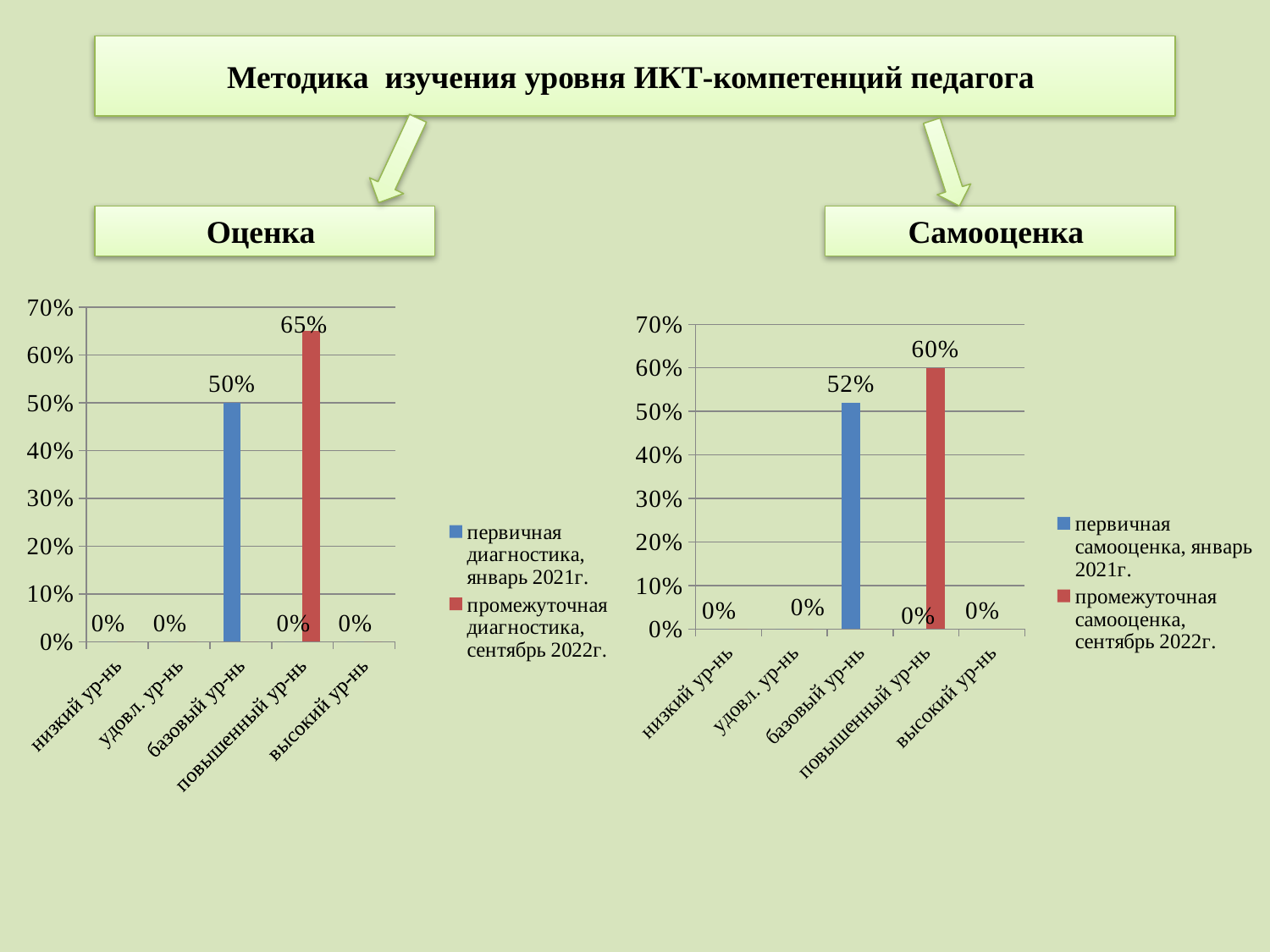
In the left chart (Оценка), which category has the highest plotted value? повышенный ур-нь How many categories are shown on the x axis of the left chart (Оценка)? 5 In the left chart (Оценка), what is the value for базовый ур-нь in the первичная диагностика, январь 2021г. series? 50% What type of chart is the left chart (Оценка)? bar chart In the right chart (Самооценка), what is the value for повышенный ур-нь in the промежуточная самооценка, сентябрь 2022г. series? 60% In the right chart (Самооценка), what is the value for базовый ур-нь in the первичная самооценка, январь 2021г. series? 52% In the right chart (Самооценка), what is the difference between the 60% bar for повышенный ур-нь and the 52% bar for базовый ур-нь? 8% In the right chart (Самооценка), is the value for повышенный ур-нь in the промежуточная самооценка series greater or less than 50%? greater How many series does the legend of the right chart (Самооценка) list? 2 In the left chart (Оценка), what is the difference between the 65% bar for повышенный ур-нь and the 50% bar for базовый ур-нь? 15% In the right chart (Самооценка), which is larger: the value for базовый ур-нь in January 2021 or the value for повышенный ур-нь in September 2022? повышенный ур-нь in September 2022 In the left chart (Оценка), what is the value for повышенный ур-нь in the промежуточная диагностика, сентябрь 2022г. series? 65%